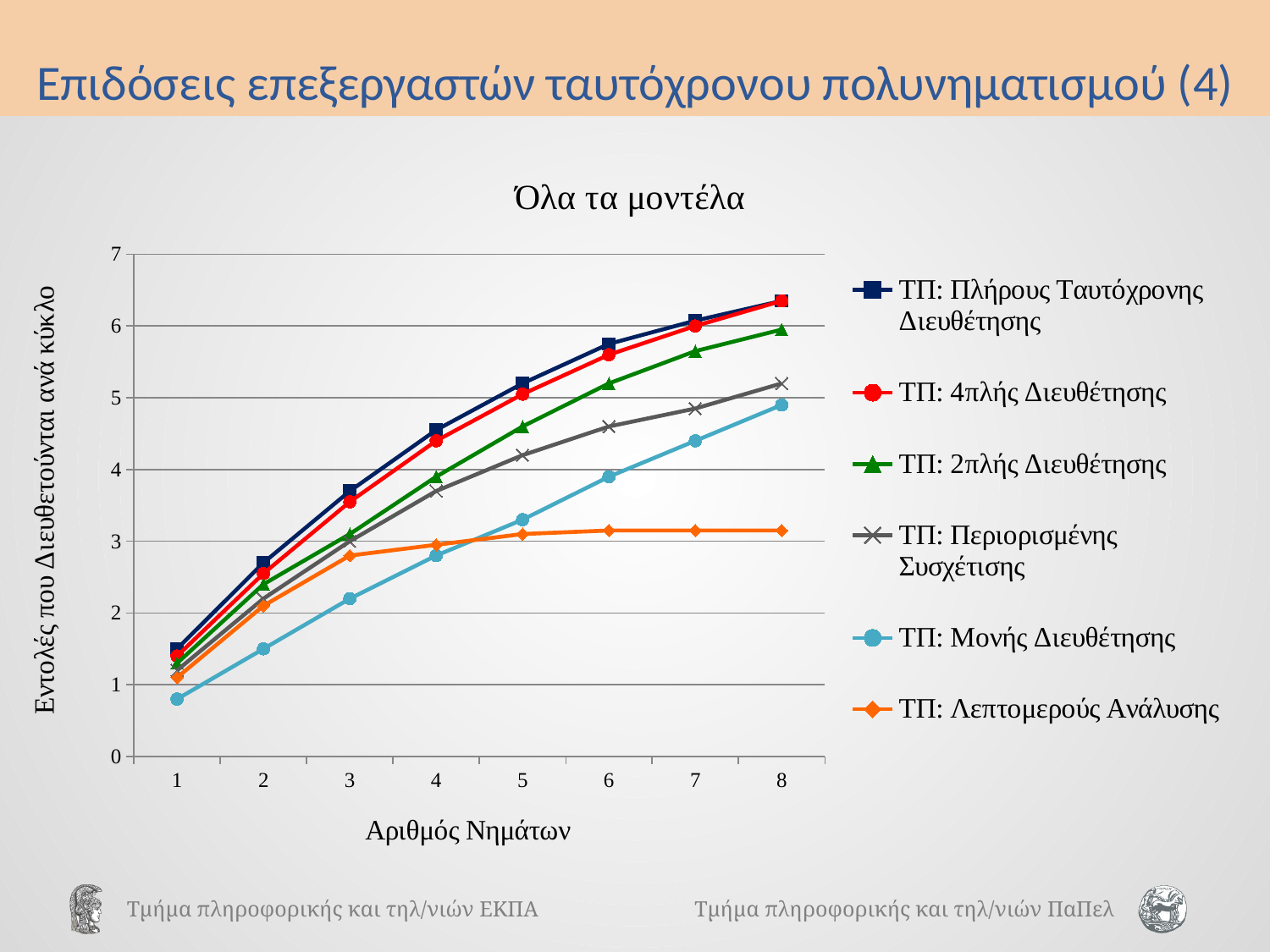
What is the title of the chart? Όλα τα μοντέλα Is the value for ΤΠ: Περιορισμένης Συσχέτισης at 8 threads greater or less than 6? less Which series has the lowest value at 8 threads? ΤΠ: Λεπτομερούς Ανάλυσης Which series has the lowest value at 1 thread? ΤΠ: Μονής Διευθέτησης At 2 threads, which is larger: ΤΠ: Πλήρους Ταυτόχρονης Διευθέτησης or ΤΠ: Μονής Διευθέτησης? ΤΠ: Πλήρους Ταυτόχρονης Διευθέτησης How many values of Αριθμός Νημάτων are plotted along the x axis? 8 Does the value for ΤΠ: Πλήρους Ταυτόχρονης Διευθέτησης rise or fall as the number of threads increases from 1 to 8? rise Is the value for ΤΠ: Λεπτομερούς Ανάλυσης at 8 threads greater or less than 4? less Is the value for ΤΠ: Μονής Διευθέτησης at 1 thread greater or less than 1? less How many series does the legend list? 6 At 8 threads, which is larger: ΤΠ: 2πλής Διευθέτησης or ΤΠ: Περιορισμένης Συσχέτισης? ΤΠ: 2πλής Διευθέτησης What kind of chart is shown on the slide? line chart